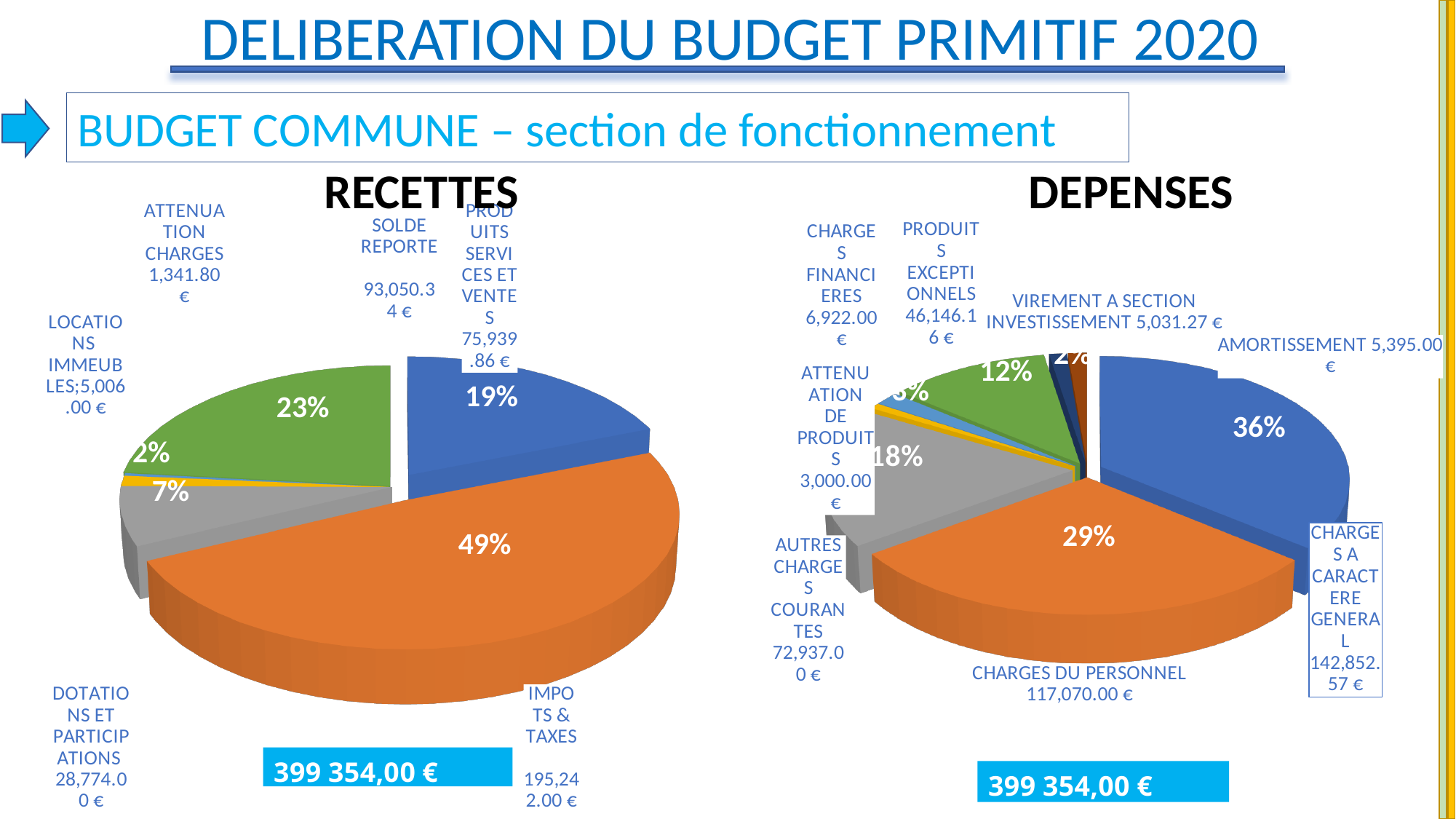
On the RECETTES chart, what share of the pie does IMPOTS & TAXES represent? 49% On the RECETTES chart, what is the value for SOLDE REPORTE? 93,050.34 € On the RECETTES chart, what is the value for IMPOTS & TAXES? 195,242.00 € What total amount is shown below the RECETTES chart? 399 354,00 € On the RECETTES chart, which category has the largest value? IMPOTS & TAXES What kind of chart is the DEPENSES chart? Pie chart On the DEPENSES chart, which category has the largest value? CHARGES A CARACTERE GENERAL On the RECETTES chart, which category has the smallest value? ATTENUATION CHARGES On the DEPENSES chart, what is the value for AUTRES CHARGES COURANTES? 72,937.00 € On the DEPENSES chart, what share of the pie does CHARGES A CARACTERE GENERAL represent? 36% On the DEPENSES chart, what is the value for CHARGES DU PERSONNEL? 117,070.00 € On the RECETTES chart, which is larger: SOLDE REPORTE or PRODUITS SERVICES ET VENTES? SOLDE REPORTE